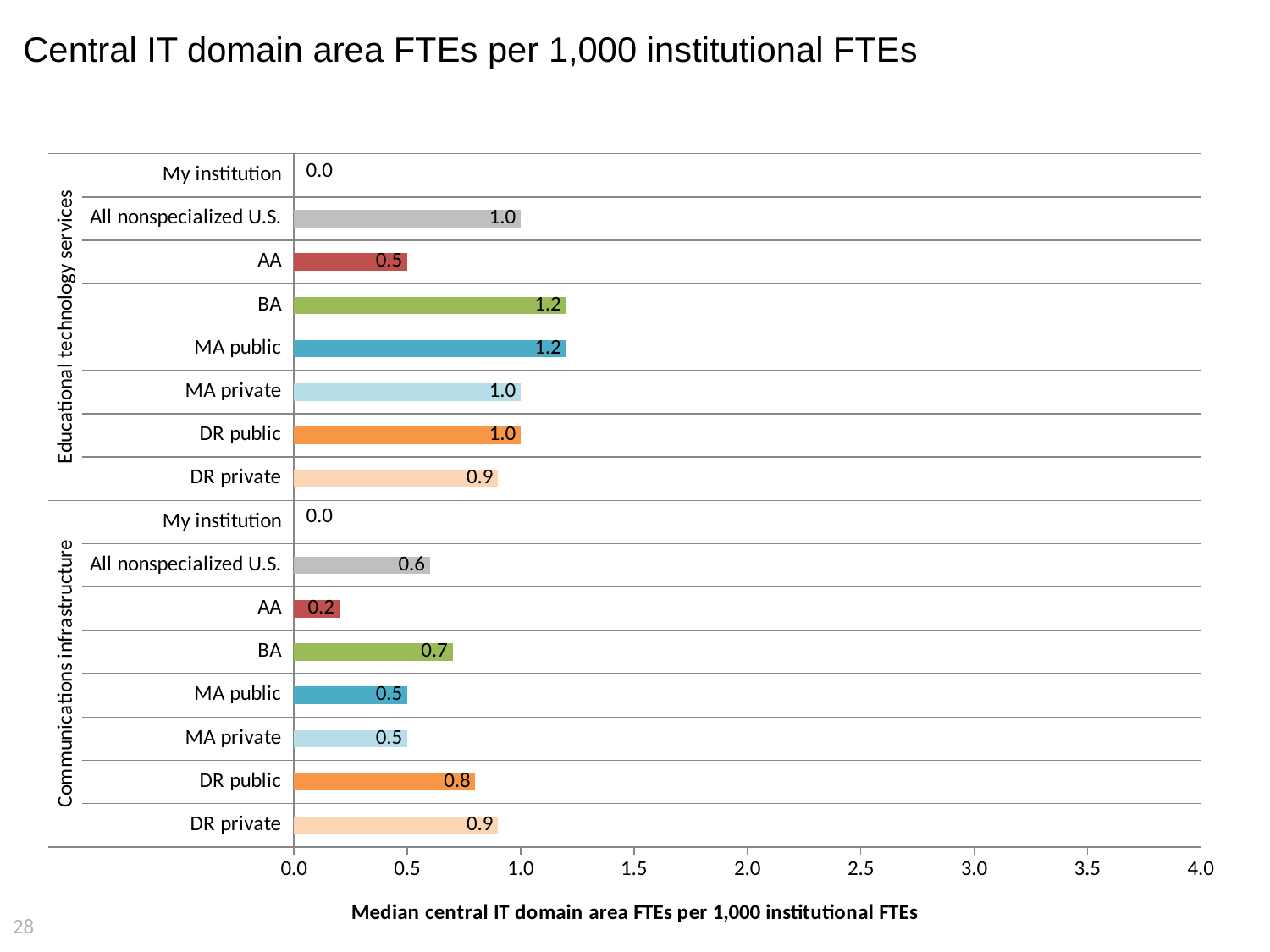
What is the label on the horizontal axis of the chart? Median central IT domain area FTEs per 1,000 institutional FTEs What is the difference between the BA value under Educational technology services and the BA value under Communications infrastructure? 0.5 Within Educational technology services, which category has the lowest non-zero value? AA What is the value for DR public under Communications infrastructure? 0.8 What is the value for BA under Educational technology services? 1.2 Within Communications infrastructure, which category has the highest value? DR private What is the value for AA under Communications infrastructure? 0.2 Which is larger: DR public under Communications infrastructure or MA public under Communications infrastructure? DR public What kind of chart is shown on the slide? Bar chart What is the value for All nonspecialized U.S. under Educational technology services? 1.0 Is the value for MA public under Educational technology services greater or less than 1.0? greater How many bars are plotted in the chart in total? 16